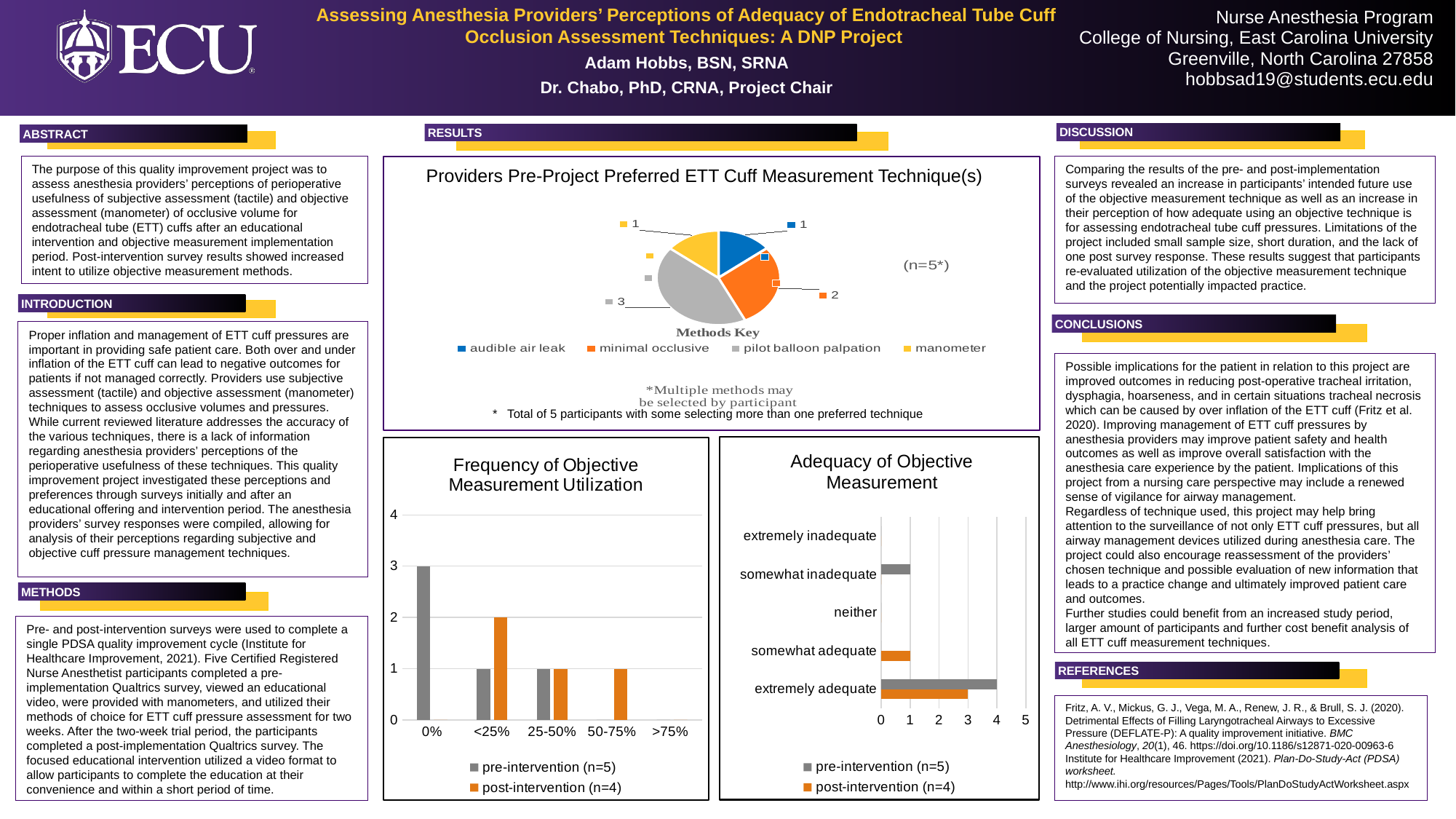
In the chart 'Frequency of Objective Measurement Utilization', what is the post-intervention (n=4) value for the <25% category? 2 In the chart 'Frequency of Objective Measurement Utilization', what is the pre-intervention (n=5) value for the 0% category? 3 How many categories are shown on the x axis of the chart 'Frequency of Objective Measurement Utilization'? 5 In the chart 'Adequacy of Objective Measurement', what is the pre-intervention (n=5) value for extremely adequate? 4 In the pie chart 'Providers Pre-Project Preferred ETT Cuff Measurement Technique(s)', what is the value for minimal occlusive? 2 In the pie chart 'Providers Pre-Project Preferred ETT Cuff Measurement Technique(s)', which technique has the largest slice? pilot balloon palpation In the chart 'Frequency of Objective Measurement Utilization', which category has the highest pre-intervention (n=5) value? 0% In the chart 'Adequacy of Objective Measurement', which series has the larger value for extremely adequate, pre-intervention (n=5) or post-intervention (n=4)? pre-intervention (n=5) In the chart 'Adequacy of Objective Measurement', what is the difference between the pre-intervention (n=5) and post-intervention (n=4) values for extremely adequate? 1 How many entries does the legend of the pie chart 'Providers Pre-Project Preferred ETT Cuff Measurement Technique(s)' list? 4 What kind of chart is 'Frequency of Objective Measurement Utilization'? bar chart In the pie chart 'Providers Pre-Project Preferred ETT Cuff Measurement Technique(s)', what is the value for pilot balloon palpation? 3